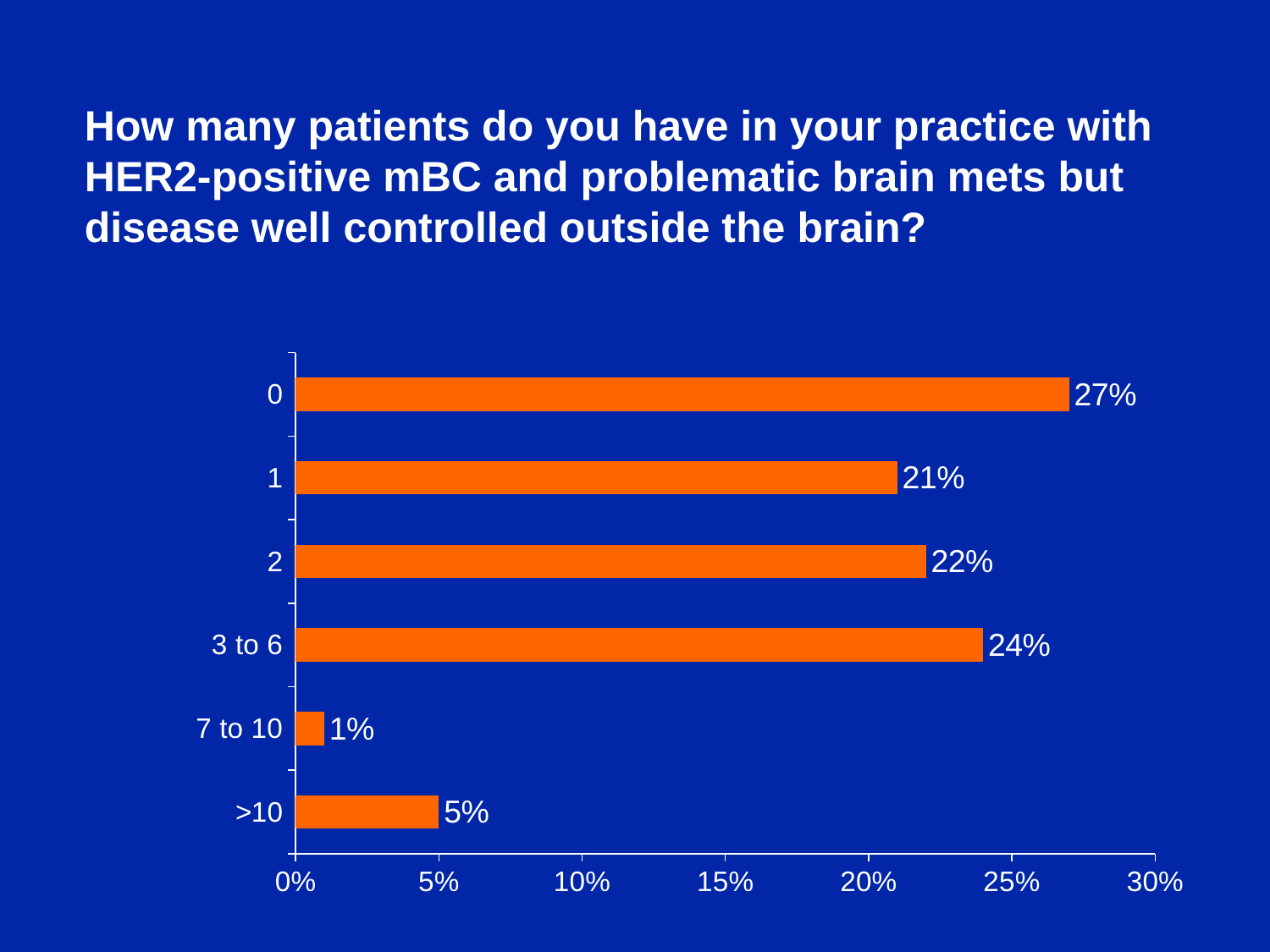
Which is larger, the value for "2" or the value for "1"? 2 Which category has the highest value? 0 What is the difference between the values for ">10" and "7 to 10"? 4% Is the value for "3 to 6" greater or less than 20%? greater Which category has the lowest value? 7 to 10 What kind of chart is shown on the slide? Bar chart How many categories are shown on the chart? 6 What is the value for the ">10" category? 5% What percentage of respondents answered "0"? 27% What is the value for the "3 to 6" category? 24% What is the difference between the values for "0" and "1"? 6% What is the maximum value shown on the x axis? 30%